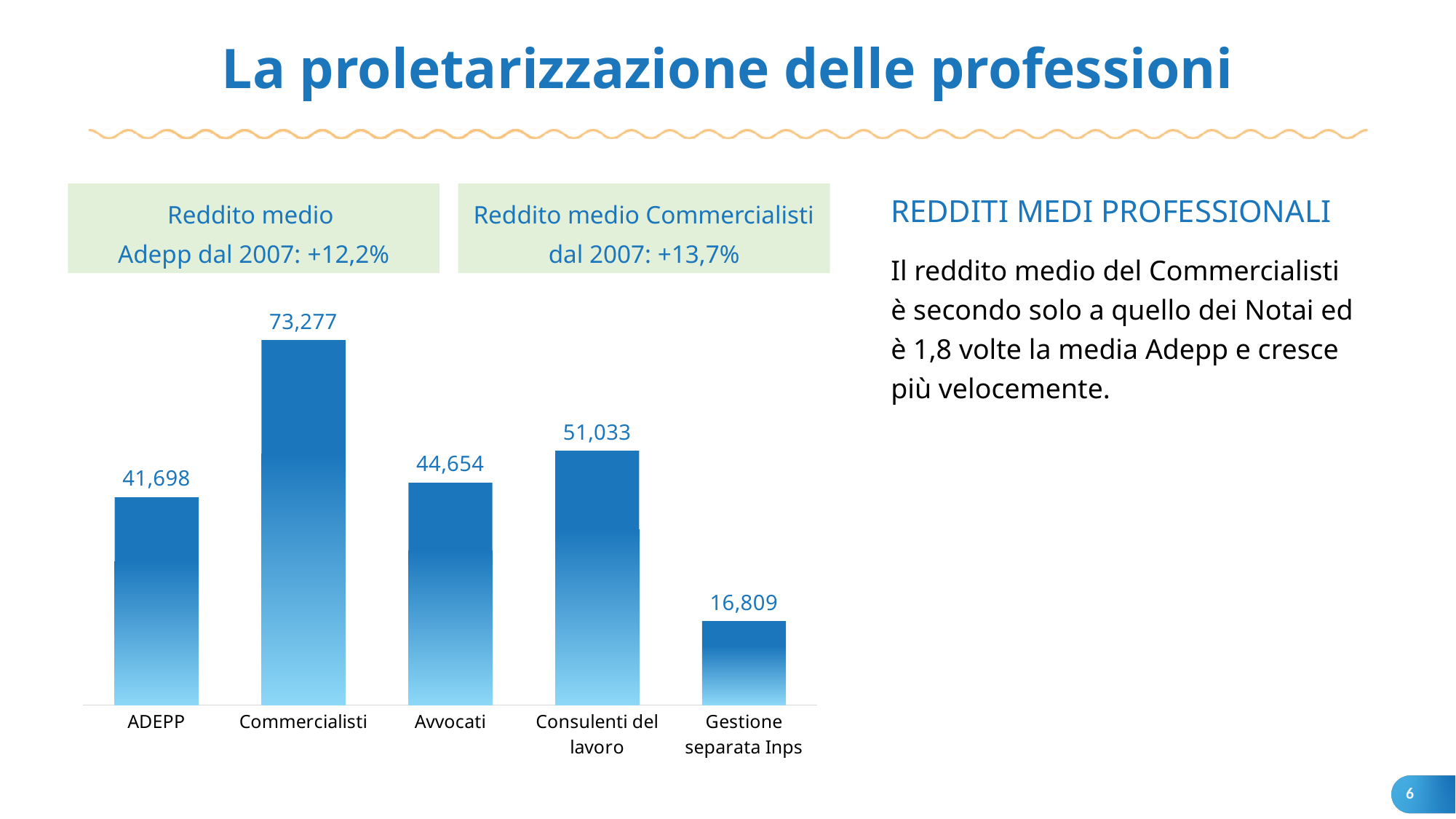
What kind of chart is shown on the slide? Bar chart What is the difference between the values for Commercialisti and Gestione separata Inps? 56,468 How many categories are shown in the chart? 5 Which category has the lowest value? Gestione separata Inps What is the value shown for Consulenti del lavoro? 51,033 Which is larger, the value for Avvocati or the value for ADEPP? Avvocati What is the value shown for ADEPP? 41,698 Which category has the highest value? Commercialisti What is the value shown for Commercialisti? 73,277 What is the value shown for Gestione separata Inps? 16,809 What is the difference between the values for Commercialisti and ADEPP? 31,579 What is the difference between the values for Consulenti del lavoro and Avvocati? 6,379